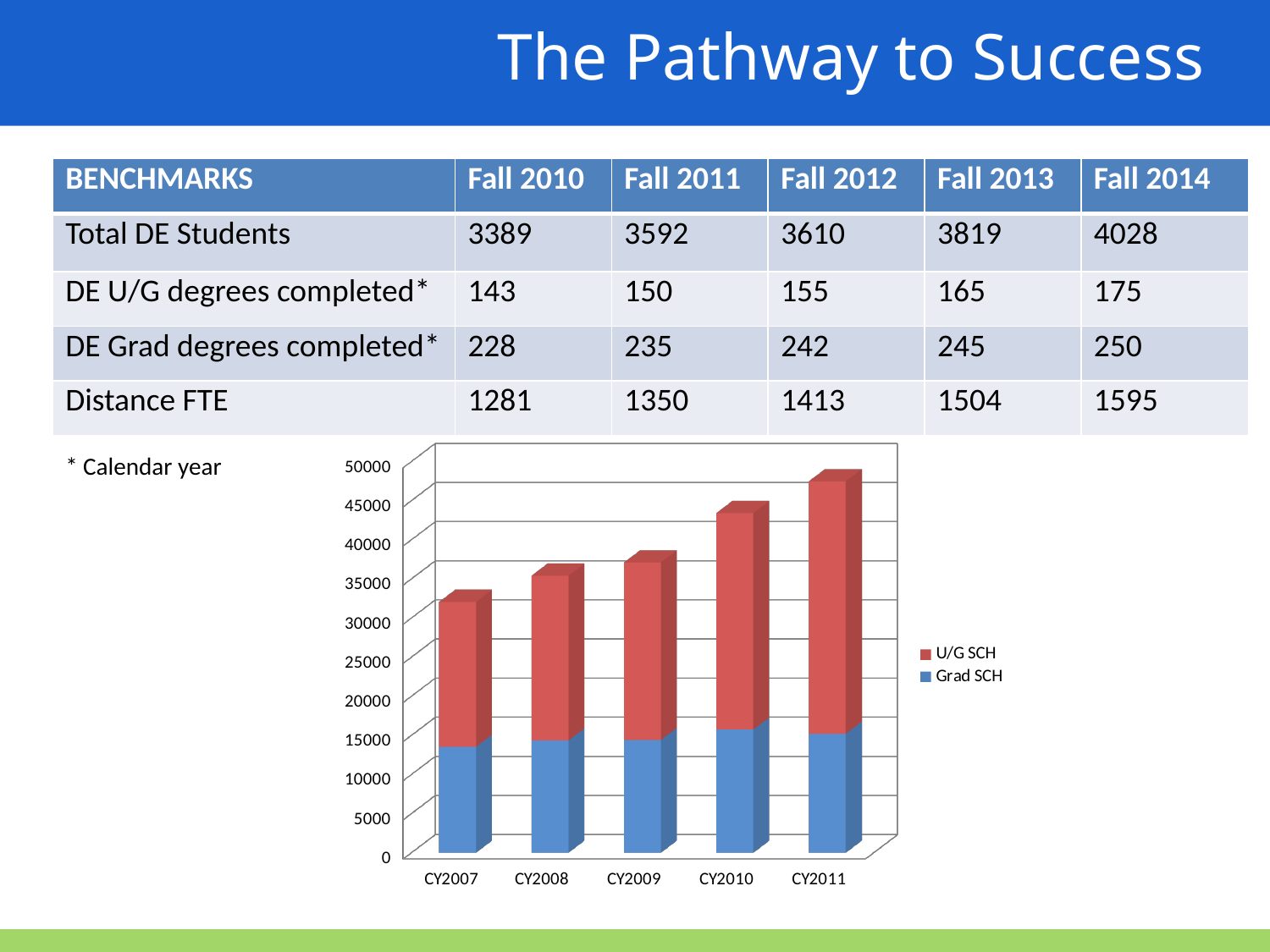
How many calendar-year categories are shown on the x axis of the chart? 5 Which calendar year has the tallest stacked bar in the chart? CY2011 How many series does the chart legend list? 2 Is the total stacked bar for CY2011 greater or less than 45000? greater Is the total stacked bar for CY2010 greater or less than 40000? greater Do the total stacked bar heights rise or fall from CY2007 to CY2011? Rise What kind of chart is shown on the slide? Stacked bar chart Which calendar year has the shortest stacked bar in the chart? CY2007 Is the total stacked bar for CY2007 greater or less than 35000? less Which series are listed in the chart legend? U/G SCH and Grad SCH What colour represents the U/G SCH series in the chart? Red Which has the larger total stacked bar, CY2009 or CY2010? CY2010